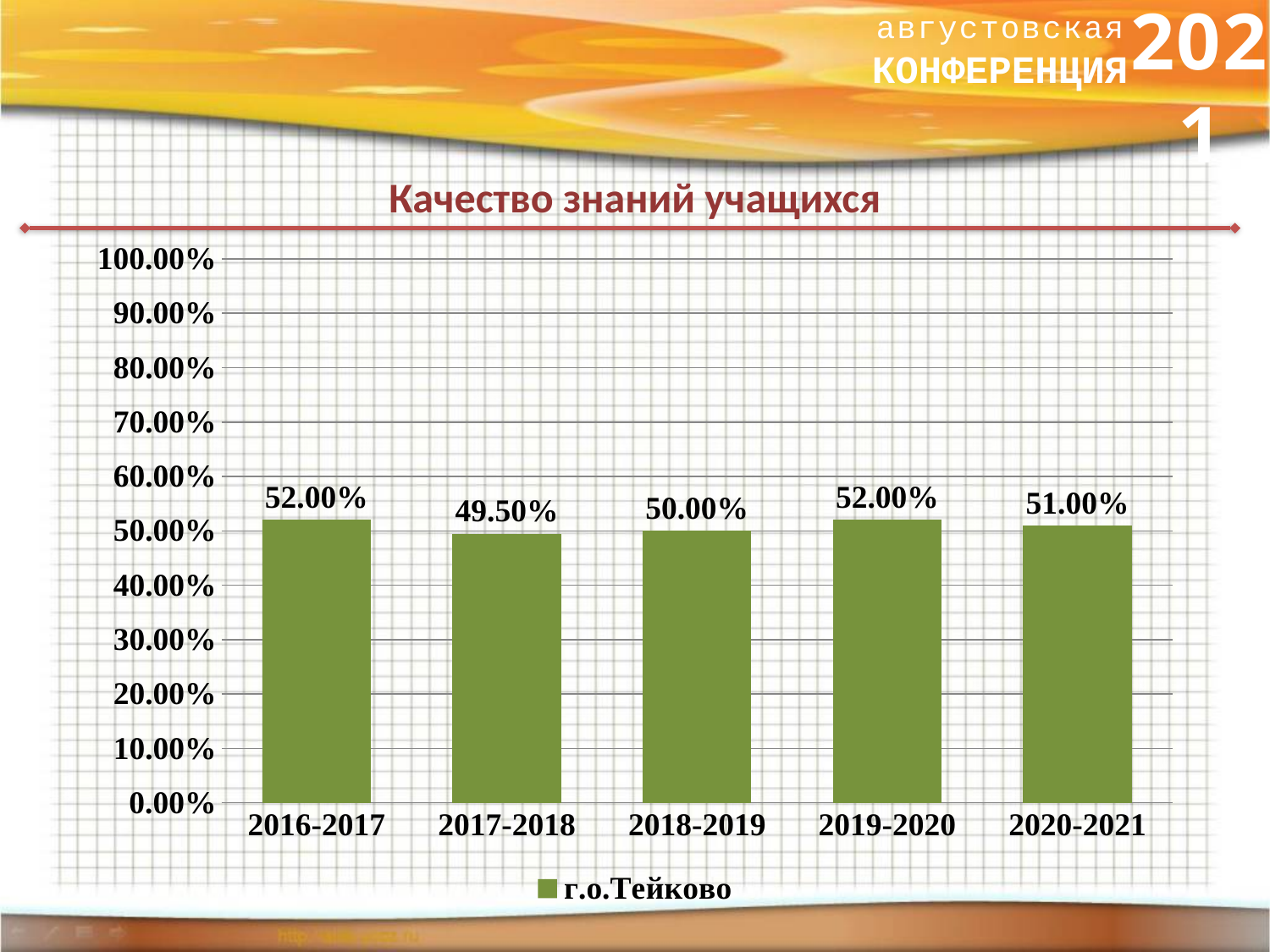
What is the difference between the values for 2016-2017 and 2017-2018? 2.50% What is the value for 2020-2021? 51.00% What is the value for 2018-2019? 50.00% Is the value for 2017-2018 greater or less than 50.00%? less What is the difference between the values for 2019-2020 and 2020-2021? 1.00% What is the value for 2016-2017? 52.00% What kind of chart is shown on the slide? bar chart Which school year has the lowest value? 2017-2018 Which is larger, the value for 2018-2019 or the value for 2020-2021? 2020-2021 What is the value for 2017-2018? 49.50% What is the title of the chart? Качество знаний учащихся How many school years are shown on the x axis? 5